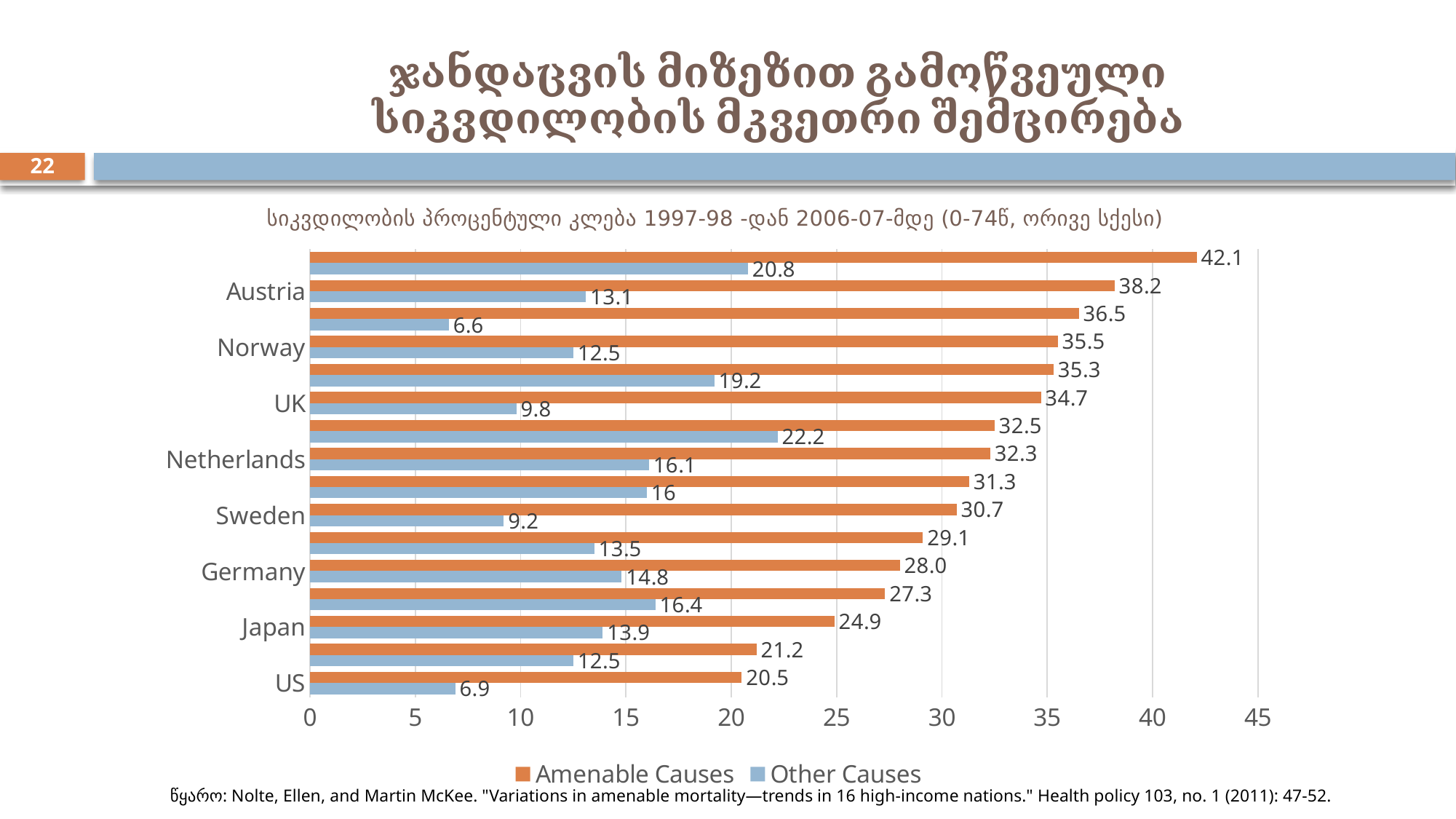
Which has a larger Other Causes value, the Netherlands or Germany? Netherlands What kind of chart is shown on the slide? Bar chart Which has a larger Amenable Causes value, Norway or Sweden? Norway How many series does the legend list? 2 What is the difference between the Amenable Causes values for Austria and the US? 17.7 What is the highest Amenable Causes value shown on the chart? 42.1 What is the Other Causes value for the UK? 9.8 For the Netherlands, what is the difference between the Amenable Causes value and the Other Causes value? 16.2 What is the Other Causes value for Germany? 14.8 Which labelled country has the lowest Amenable Causes value? US What is the Amenable Causes value for Austria? 38.2 What is the Amenable Causes value for Japan? 24.9